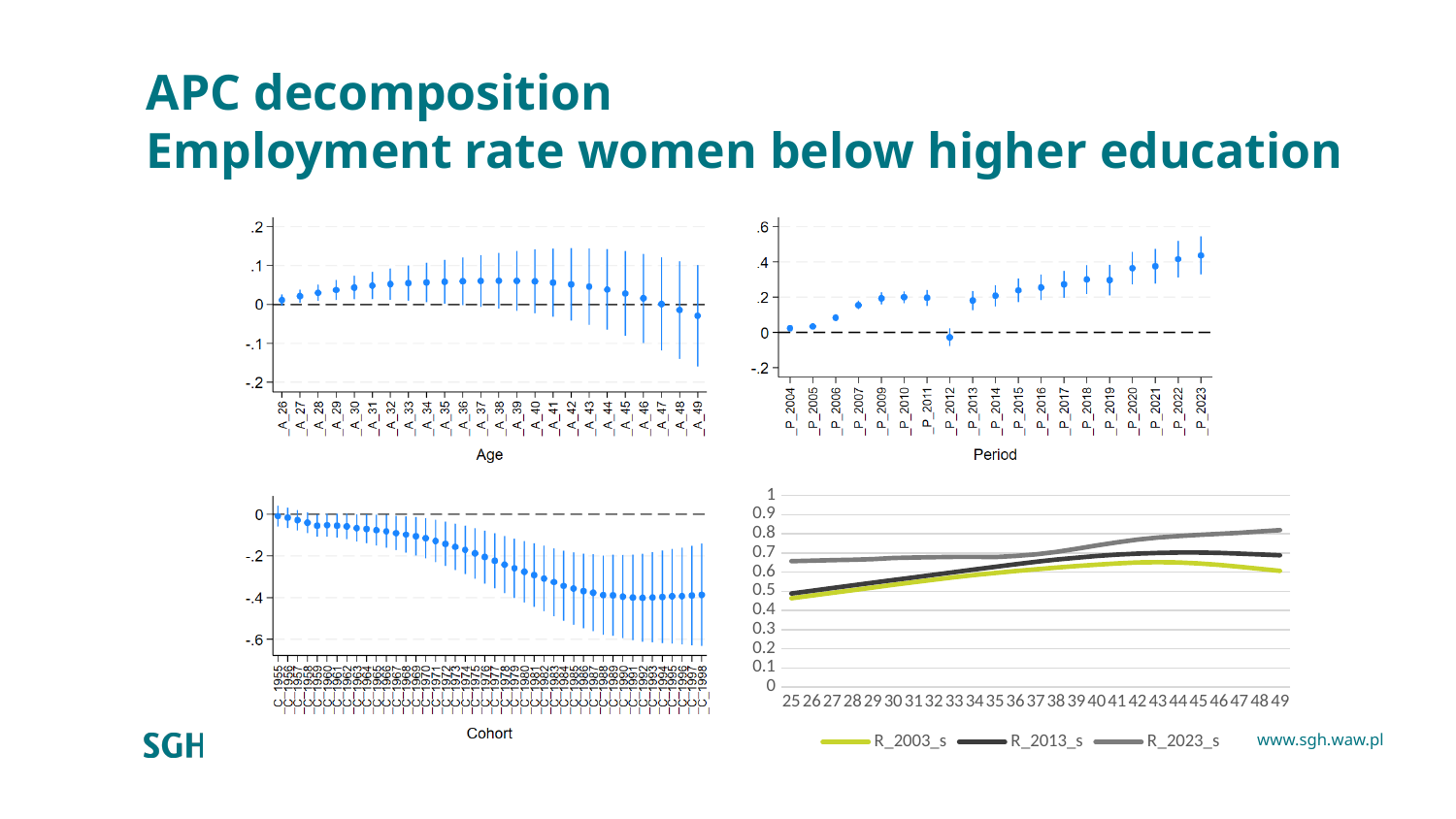
On the Period chart (top right), which period has the lowest point estimate? P_2012 On the Period chart (top right), do the point estimates generally rise or fall from P_2004 to P_2023? rise On the bottom-right line chart, is the value for R_2023_s at age 49 greater or less than 0.7? greater On the Cohort chart (bottom left), do the point estimates generally rise or fall from C_1955 to C_1998? fall On the bottom-right line chart, how many age values are shown along the x axis? 25 On the bottom-right line chart, which series has the lowest value at age 49? R_2003_s On the bottom-right line chart, how many series does the legend list? 3 On the bottom-right line chart, which series has the highest value at age 49? R_2023_s What is the x-axis title of the top-left chart? Age On the Cohort chart (bottom left), is the value for C_1990 greater or less than -0.2? less What kind of chart is the bottom-right chart with the R_2003_s, R_2013_s and R_2023_s series? line chart On the bottom-right line chart, is the value for R_2013_s at age 25 greater or less than 0.4? greater